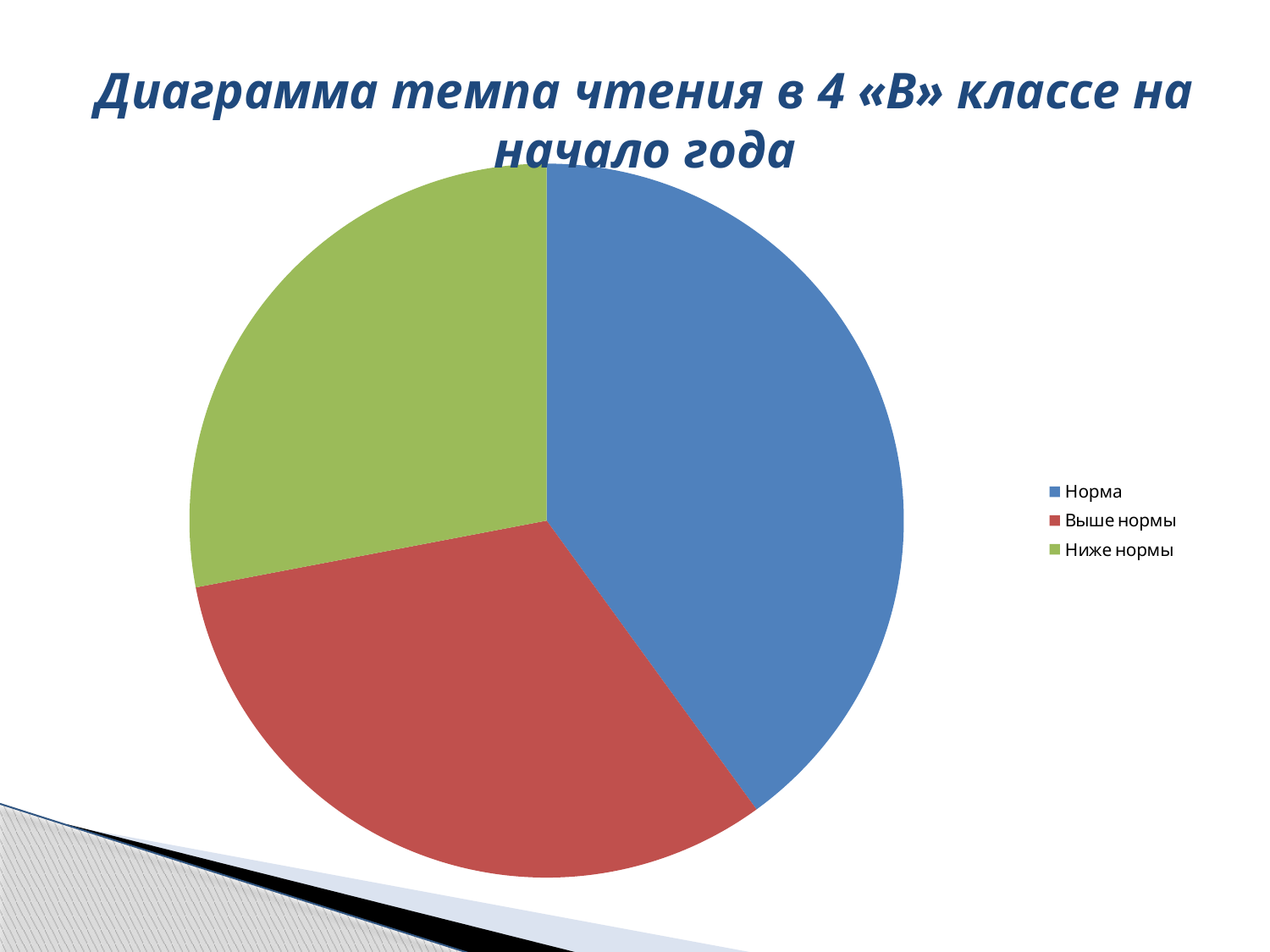
Which slice is larger, Норма or Выше нормы? Норма How many slices does the pie chart have? 3 What is the title of the chart? Диаграмма темпа чтения в 4 «В» классе на начало года Which category has the largest slice of the pie? Норма How many entries does the legend list? 3 What colour is the slice for Ниже нормы? green Which slice is larger, Норма or Ниже нормы? Норма What kind of chart is shown on the slide? pie chart